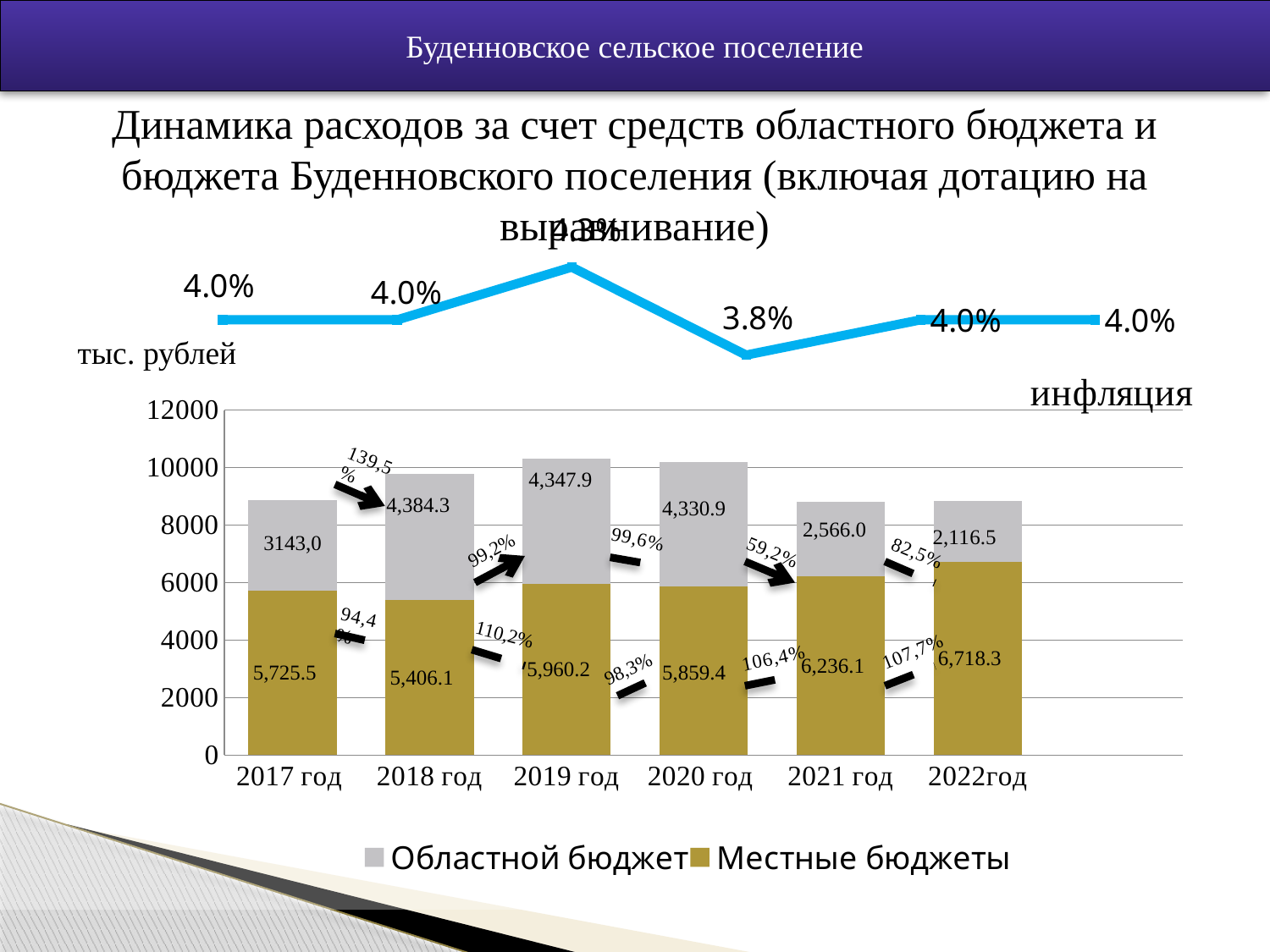
In the stacked bar chart, what is the value for Местные бюджеты in 2017 год? 5,725.5 In the stacked bar chart, is the total height of the 2019 год bar greater or less than 10000? greater In the stacked bar chart, what is the value for Областной бюджет in 2020 год? 4,330.9 In the stacked bar chart, which year has the highest value for Местные бюджеты? 2022год How many years are shown on the x axis of the stacked bar chart? 6 In the stacked bar chart, does the Областной бюджет value rise or fall from 2018 год to 2022год? fall What is the total of the stacked bar for 2021 год? 8,802.1 In the stacked bar chart, which is larger: Областной бюджет in 2018 год or Областной бюджет in 2021 год? 2018 год In the stacked bar chart, which year has the lowest value for Областной бюджет? 2022год In the stacked bar chart, what is the difference between the Местные бюджеты values for 2022год and 2021 год? 482.2 In the stacked bar chart, what is the value for Областной бюджет in 2022год? 2,116.5 How many series does the legend of the stacked bar chart list? 2